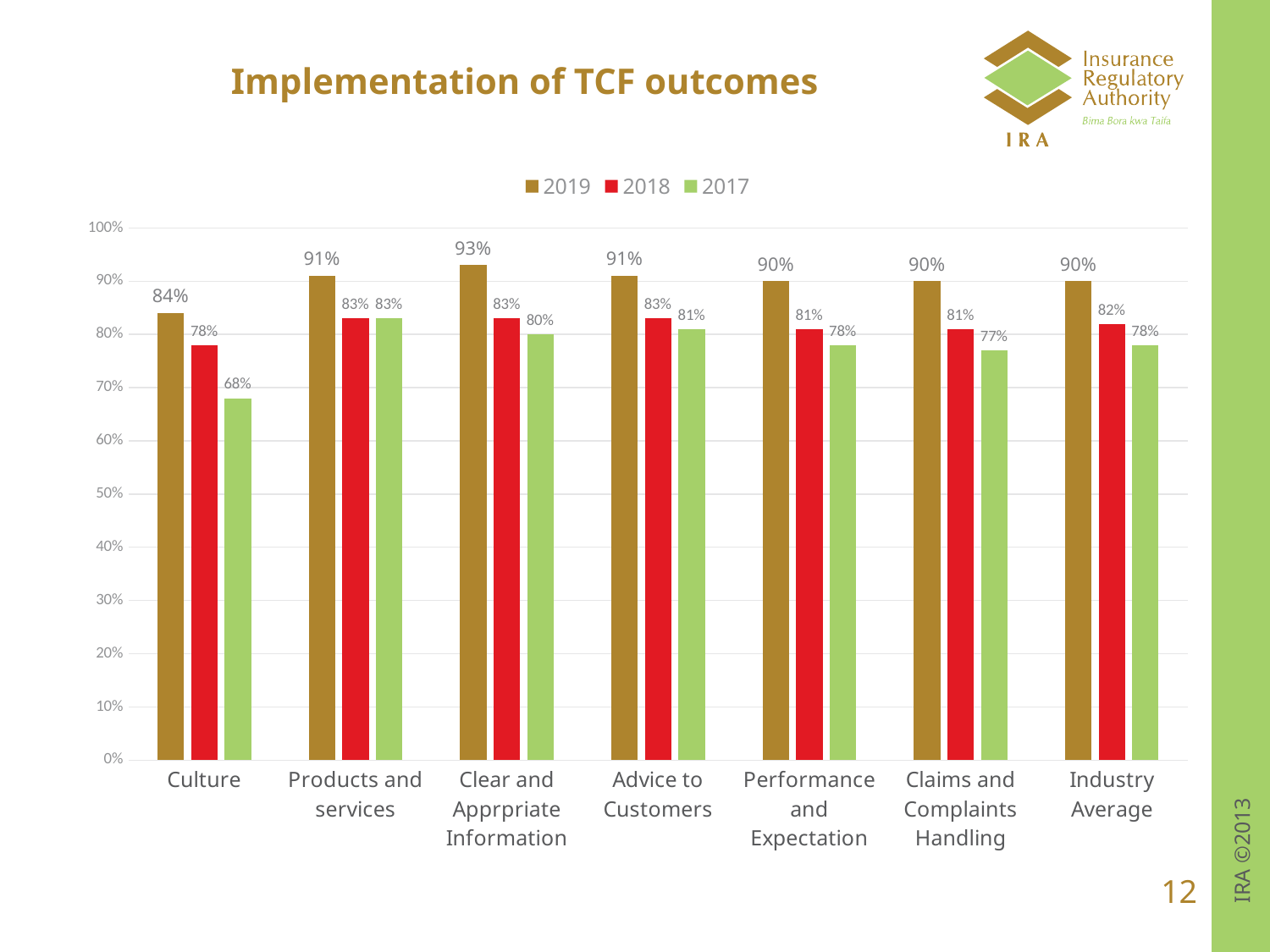
Which is larger for Claims and Complaints Handling: the 2018 value or the 2017 value? 2018 What is the 2017 value for Culture? 68% Is the 2019 value for Culture greater or less than 80%? greater How many categories are shown on the x axis? 7 What kind of chart is shown on the slide? bar chart Which category has the highest 2019 value? Clear and Apprpriate Information How many series does the legend list? 3 Which category has the lowest 2017 value? Culture What is the title of the slide? Implementation of TCF outcomes What is the difference between the 2019 and 2017 values for Culture? 16% What is the 2018 value for Industry Average? 82% What is the 2019 value for Clear and Apprpriate Information? 93%